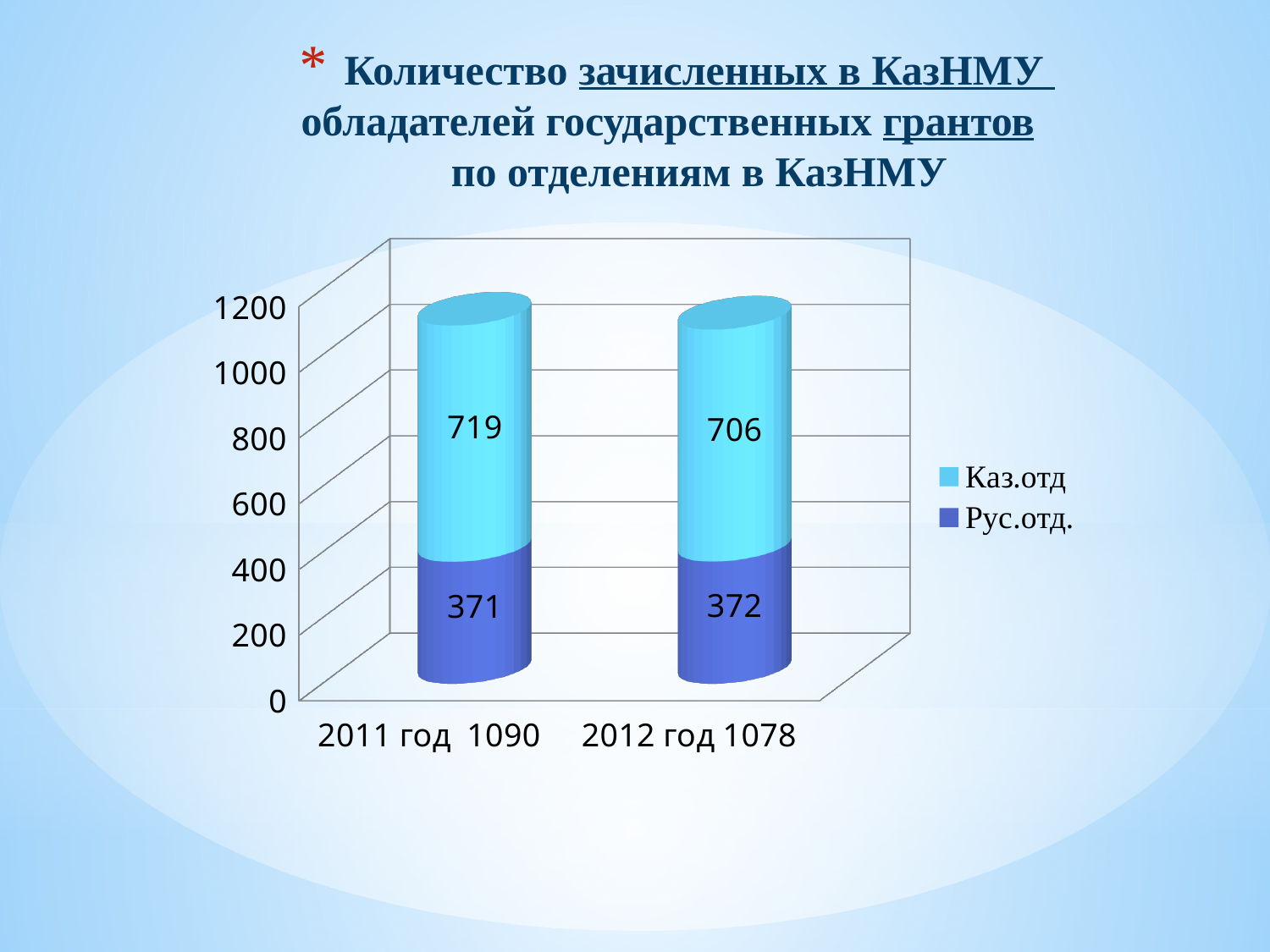
What is the total of the stacked bar for 2012 год? 1078 How many series does the legend list? 2 How many categories are shown on the x axis? 2 What is the difference between the Каз.отд values for 2011 год and 2012 год? 13 In which year is the Каз.отд value higher? 2011 год What kind of chart is shown on the slide? Stacked bar chart What is the total of the stacked bar for 2011 год? 1090 What is the value for Рус.отд. in 2012 год? 372 Which is larger in 2011 год: Каз.отд or Рус.отд.? Каз.отд What is the value for Рус.отд. in 2011 год? 371 What is the value for Каз.отд in 2011 год? 719 What is the value for Каз.отд in 2012 год? 706